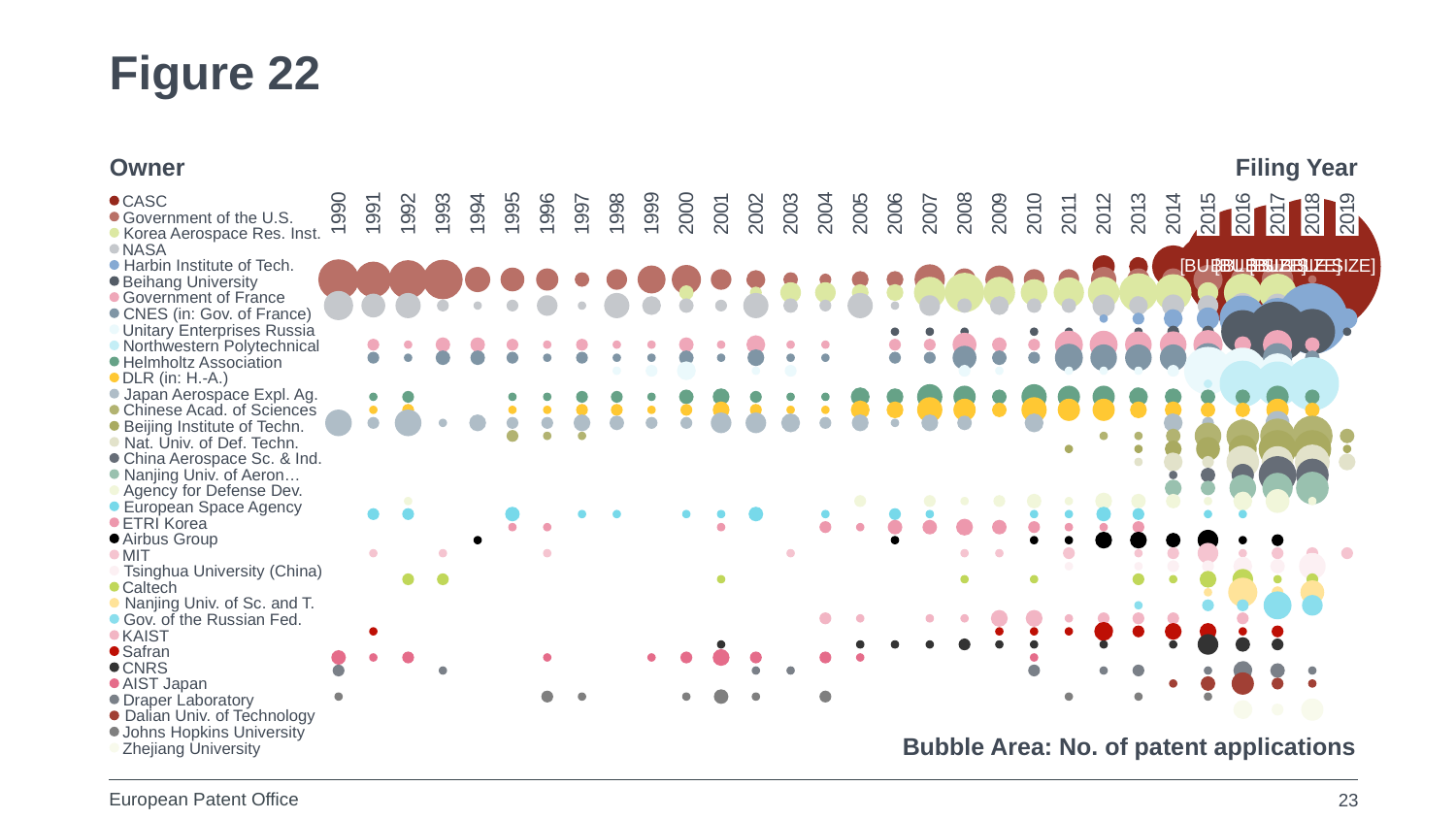
What does the bubble area represent according to the slide? No. of patent applications What is the latest filing year shown on the x axis? 2019 How many filing years are shown along the x axis? 30 How many owners are listed in the legend? 35 What is the earliest filing year shown on the x axis? 1990 What kind of chart is shown on the slide? bubble chart What is the label of the horizontal axis? Filing Year Is the CASC bubble larger in 2019 or in 1990? 2019 Do the bubbles for CASC get larger or smaller toward the later filing years? larger